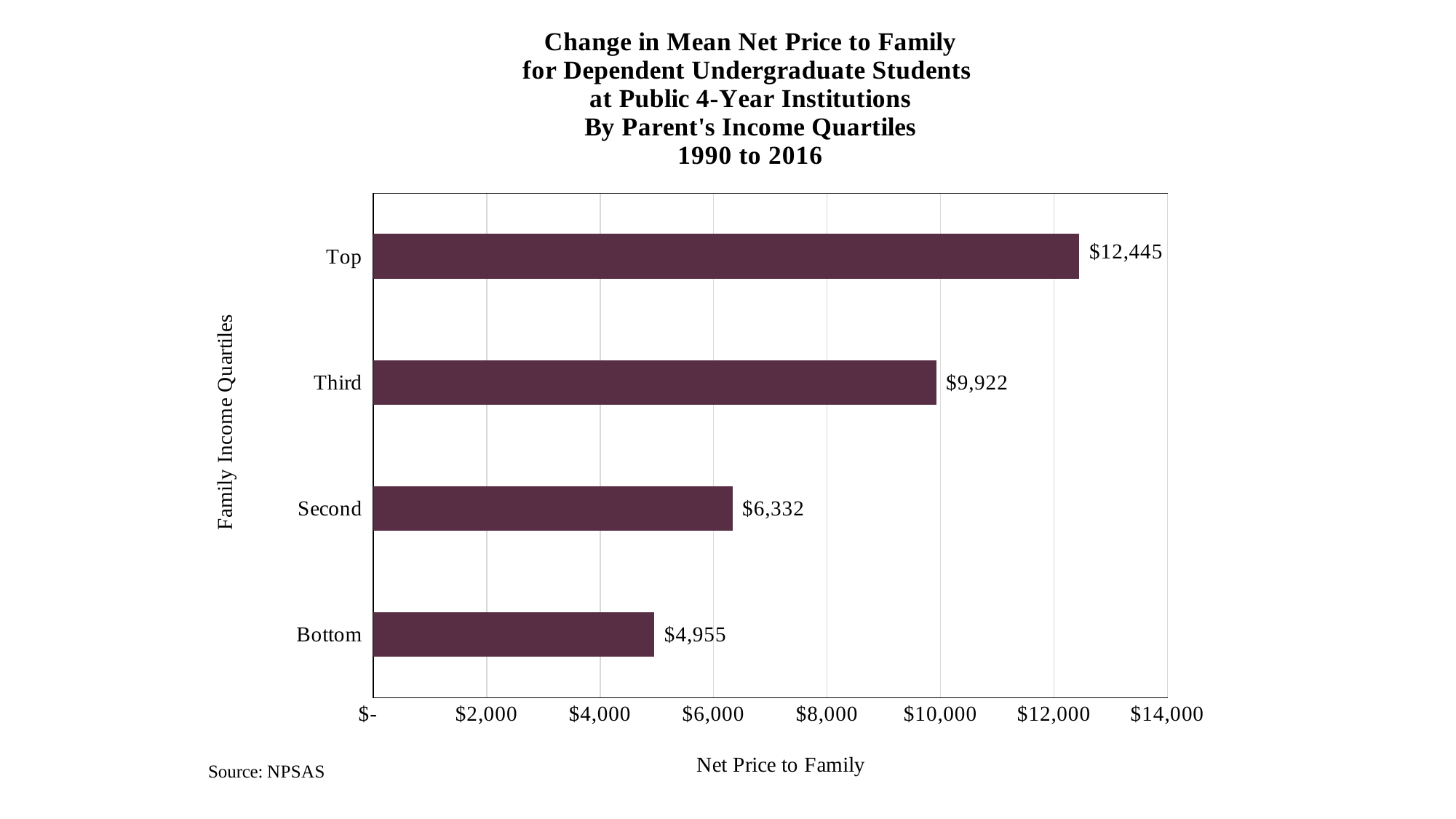
What kind of chart is shown on the slide? bar chart What is the value shown for the Third income quartile? $9,922 Which is larger, the value for the Third quartile or the Second quartile? Third What is the difference between the Top and Bottom quartile values? $7,490 What is the change in mean net price to family for the Top income quartile? $12,445 What is the value shown for the Second income quartile? $6,332 Which family income quartile has the lowest change in net price? Bottom What is the change in mean net price to family for the Bottom income quartile? $4,955 How many family income quartiles are shown on the chart? 4 Which family income quartile has the highest change in net price? Top What is the difference between the Third and Second quartile values? $3,590 Is the value for the Second quartile greater or less than $8,000? less